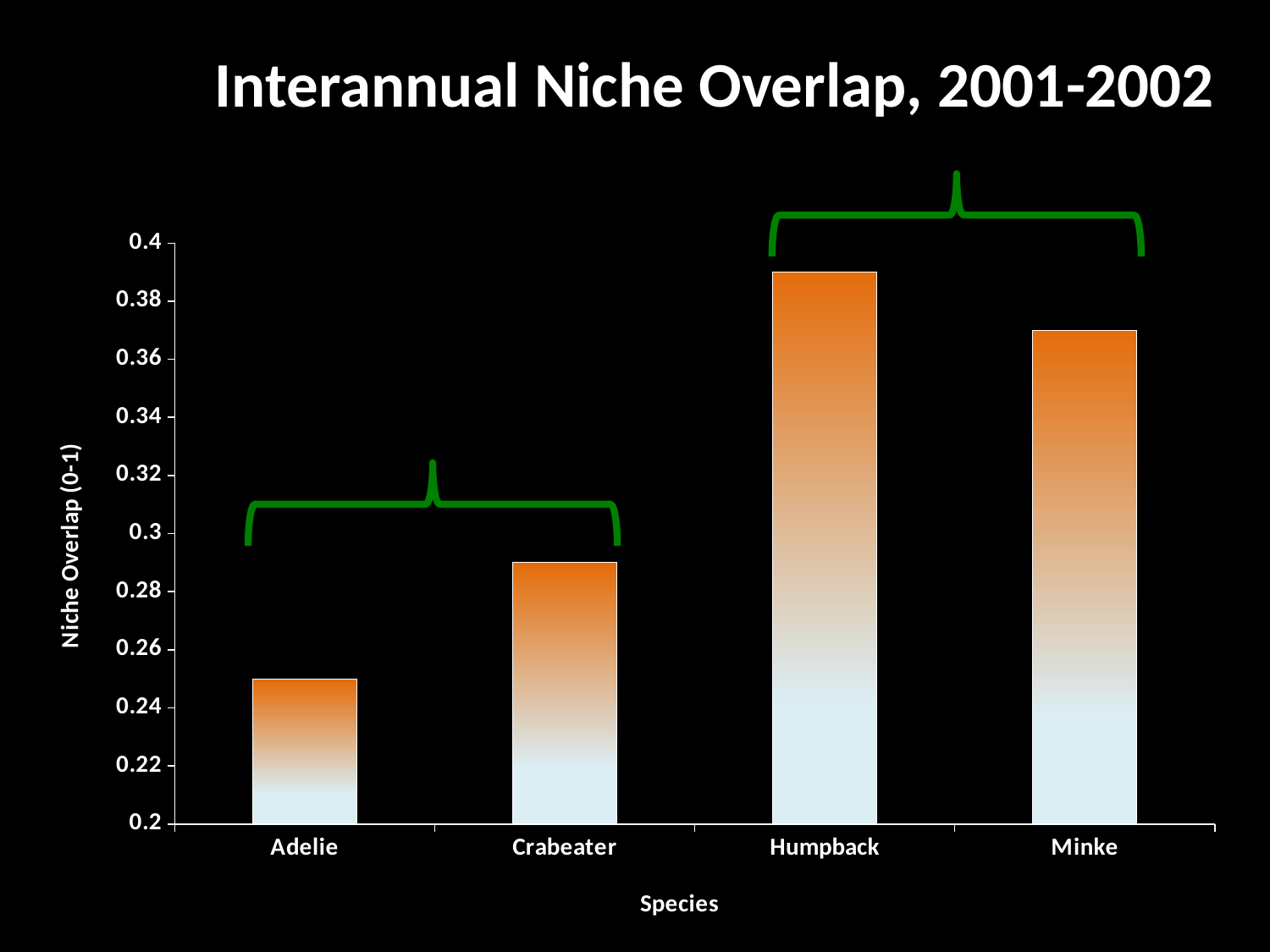
What is the label of the y axis? Niche Overlap (0-1) Is the value for Minke greater or less than 0.34? greater Which species has the lowest niche overlap? Adelie What is the title of the chart? Interannual Niche Overlap, 2001-2002 How many species are shown on the x axis? 4 Which has a higher niche overlap, Humpback or Minke? Humpback Is the value for Humpback greater or less than 0.36? greater Which species has the highest niche overlap? Humpback Is the value for Adelie greater or less than 0.3? less What kind of chart is shown on the slide? bar chart Which has a higher niche overlap, Adelie or Crabeater? Crabeater